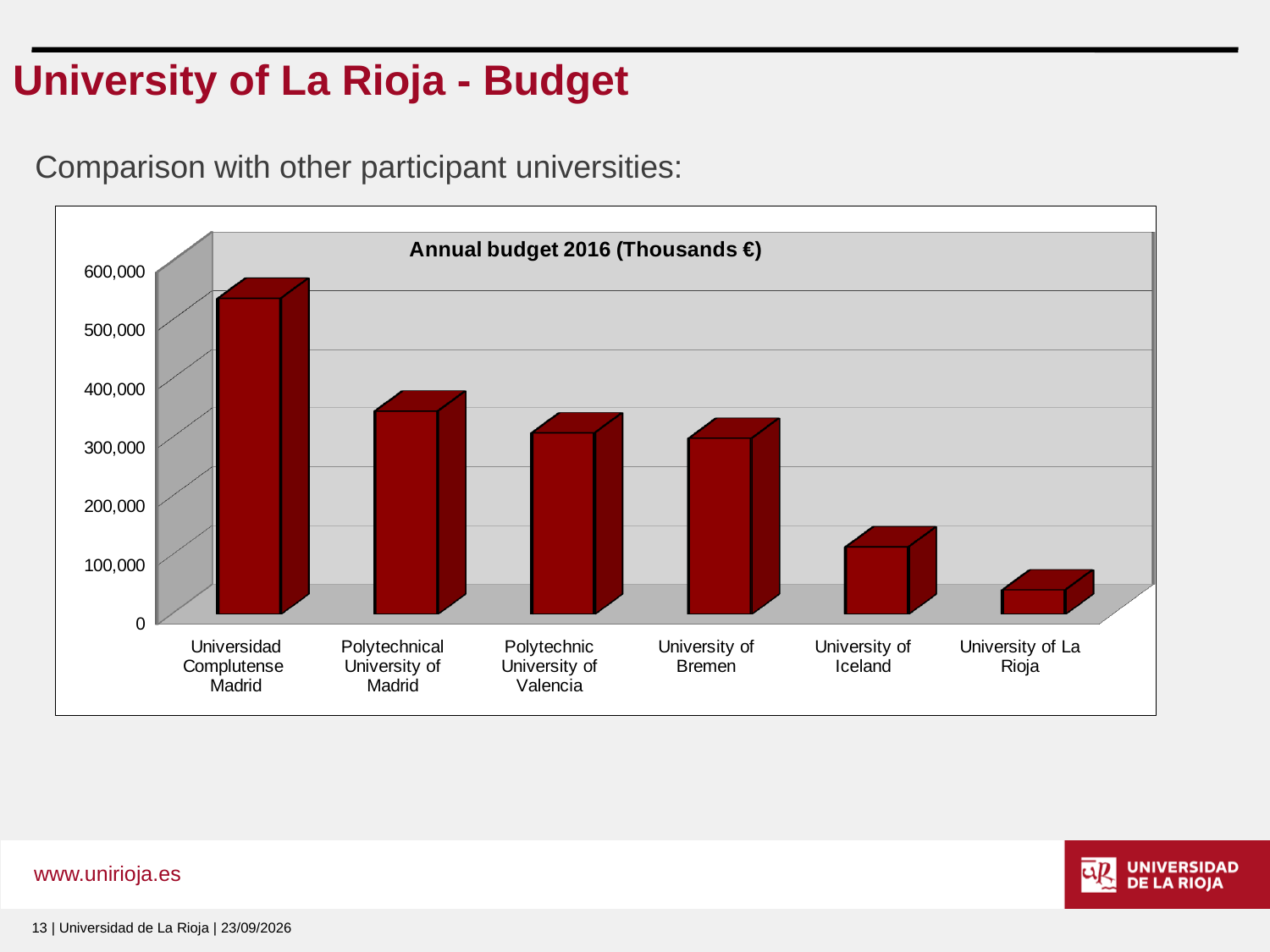
Is the value for Polytechnical University of Madrid greater or less than 300,000? greater What is the title of the chart? Annual budget 2016 (Thousands €) Which university has the highest annual budget in the chart? Universidad Complutense Madrid Which university has the lowest annual budget in the chart? University of La Rioja Is the value for University of La Rioja greater or less than 100,000? less Is the value for Universidad Complutense Madrid greater or less than 500,000? greater What kind of chart is shown on the slide? Bar chart How many universities are shown in the chart? 6 Which has a larger annual budget, Universidad Complutense Madrid or Polytechnical University of Madrid? Universidad Complutense Madrid Do the bar values rise or fall from left to right across the chart? Fall Which has a larger annual budget, University of Iceland or University of La Rioja? University of Iceland